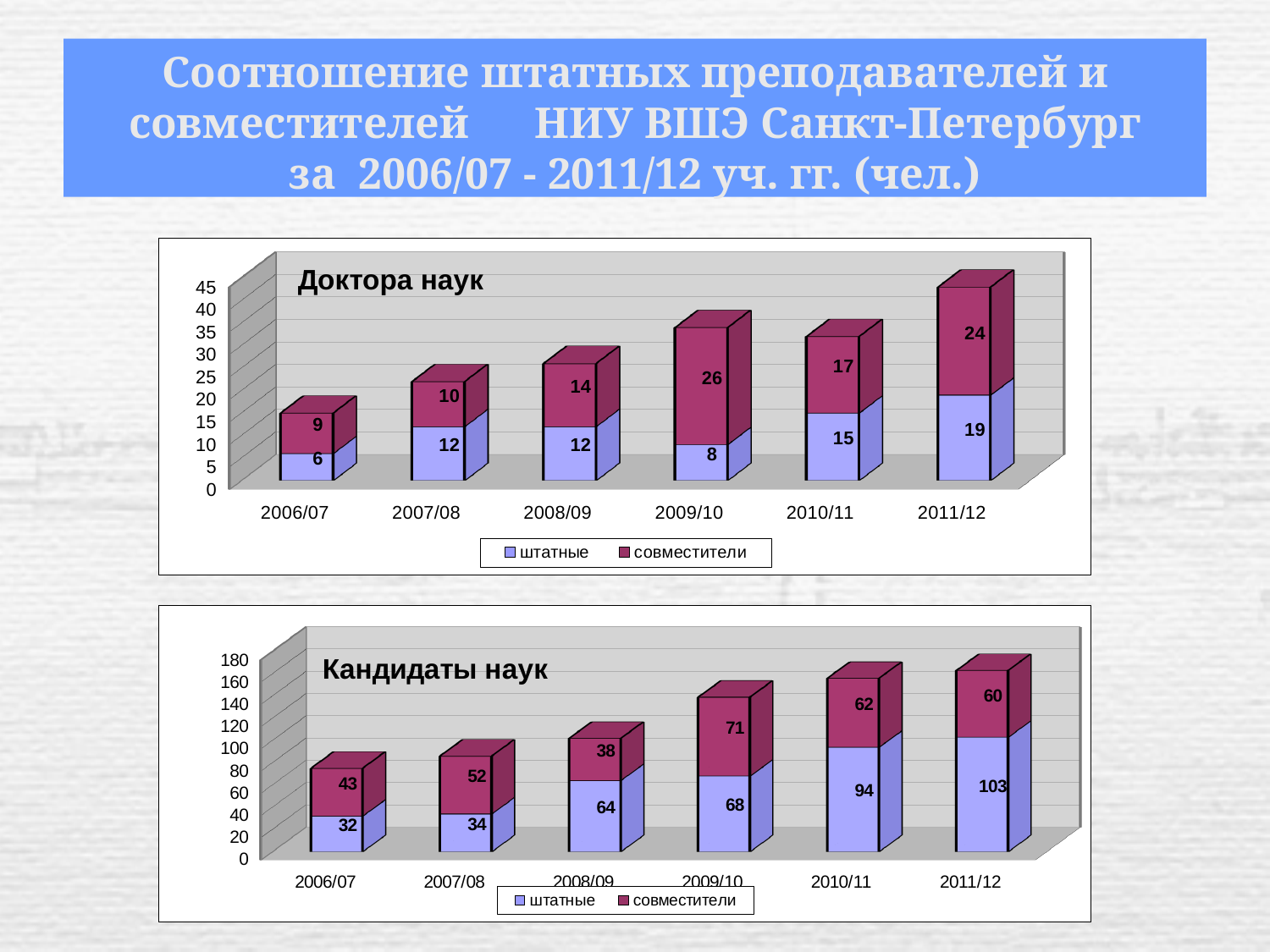
In the "Доктора наук" chart, what is the value for совместители in 2009/10? 26 In the "Кандидаты наук" chart, what is the difference between штатные in 2011/12 and штатные in 2006/07? 71 In the "Доктора наук" chart, what is the value for штатные in 2011/12? 19 How many years are shown on the x axis of the "Кандидаты наук" chart? 6 In the "Кандидаты наук" chart, what is the value for штатные in 2010/11? 94 In the "Кандидаты наук" chart, what is the value for совместители in 2007/08? 52 In the "Доктора наук" chart, which is larger in 2010/11: штатные or совместители? совместители In the "Доктора наук" chart, what is the total of the stacked bar for 2009/10? 34 In the "Доктора наук" chart, which year has the highest value for совместители? 2009/10 In the "Кандидаты наук" chart, which year has the lowest value for штатные? 2006/07 In the "Кандидаты наук" chart, what is the total of the stacked bar for 2011/12? 163 How many series does the legend of the "Доктора наук" chart list? 2